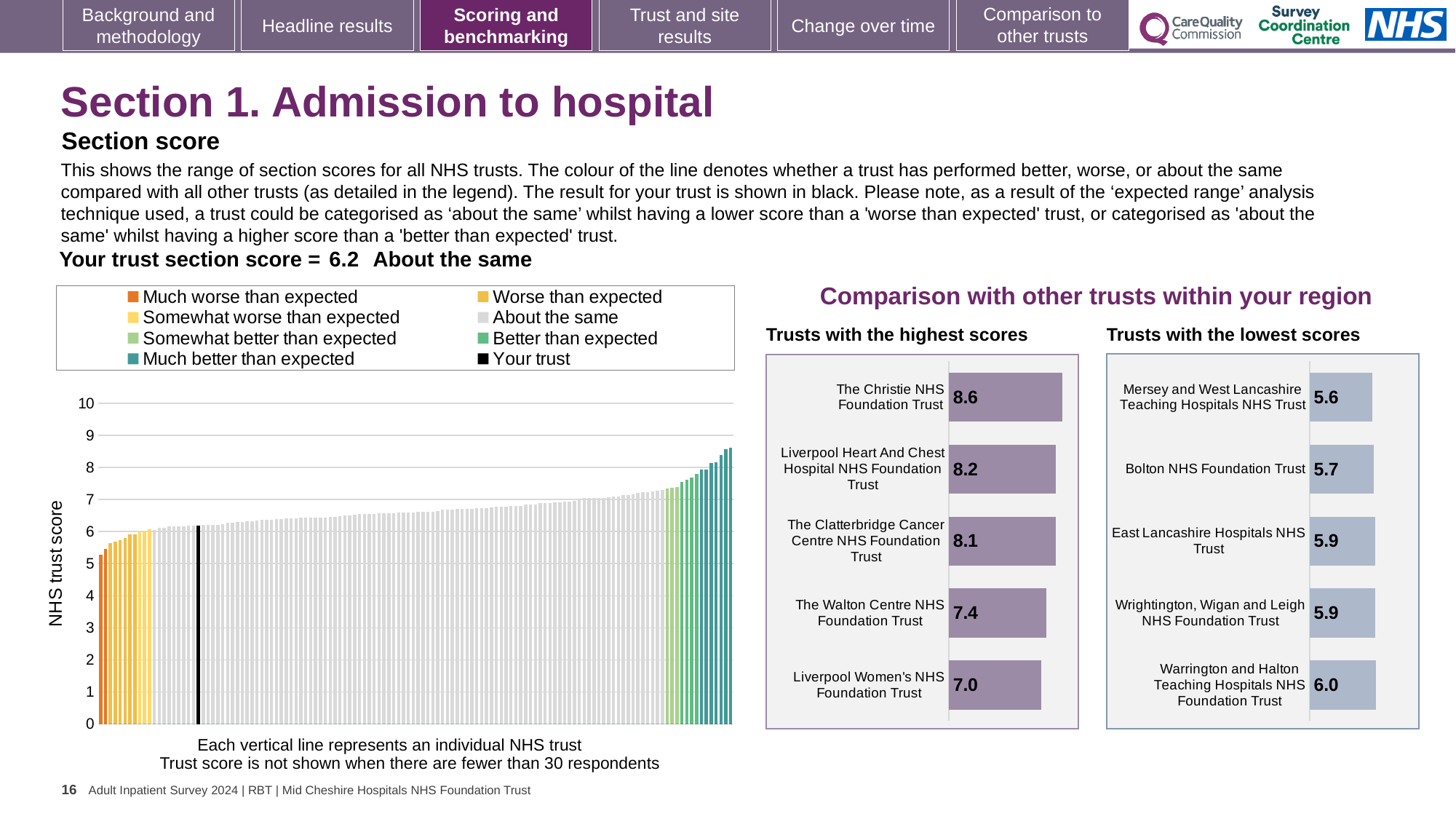
In the 'Trusts with the lowest scores' chart, which trust has the lowest score? Mersey and West Lancashire Teaching Hospitals NHS Trust In the large chart on the left, is the value of the black bar (your trust) greater or less than 7? less In the 'Trusts with the highest scores' chart, what is the difference between the scores of The Christie NHS Foundation Trust and Liverpool Women's NHS Foundation Trust? 1.6 How many entries does the legend of the large chart on the left list? 8 In the 'Trusts with the lowest scores' chart, which has the higher score: Bolton NHS Foundation Trust or Warrington and Halton Teaching Hospitals NHS Foundation Trust? Warrington and Halton Teaching Hospitals NHS Foundation Trust In the 'Trusts with the highest scores' chart, what is the score for The Walton Centre NHS Foundation Trust? 7.4 In the 'Trusts with the highest scores' chart, what is the score for The Christie NHS Foundation Trust? 8.6 In the 'Trusts with the lowest scores' chart, what is the score for Bolton NHS Foundation Trust? 5.7 What type of chart is the large chart on the left showing NHS trust scores? Bar chart In the large chart on the left, do the NHS trust scores rise or fall from left to right? Rise How many trusts are shown in the 'Trusts with the lowest scores' chart? 5 In the 'Trusts with the highest scores' chart, which trust has the lowest score shown? Liverpool Women's NHS Foundation Trust